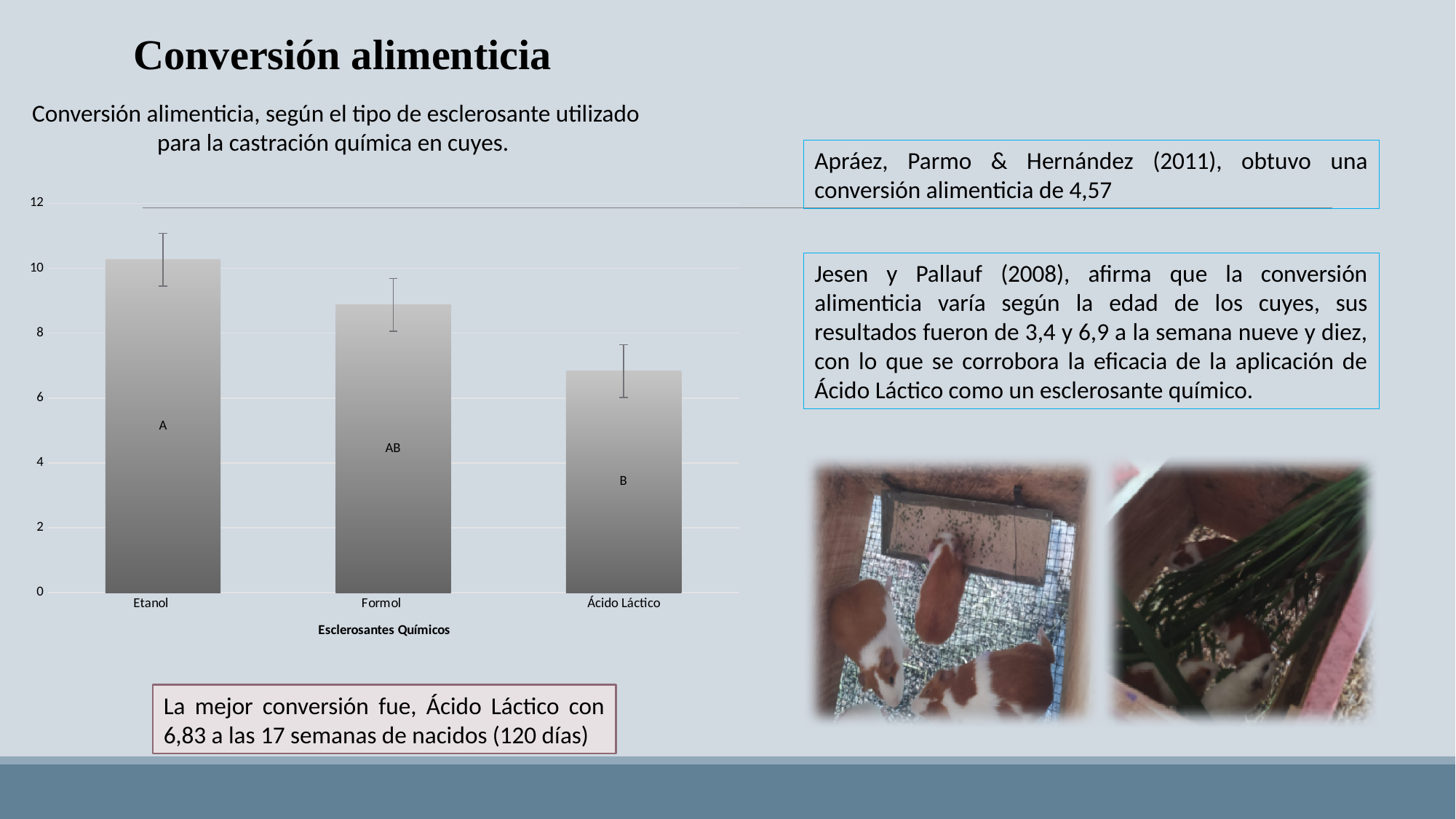
Which has a larger value in the chart, Etanol or Formol? Etanol Do the bar values rise or fall from Etanol to Ácido Láctico along the x axis? fall Which esclerosante has the lowest conversión alimenticia in the chart? Ácido Láctico Is the value for Formol greater or less than 10? less What is the title of the x axis of the chart? Esclerosantes Químicos What kind of chart is shown on the slide? bar chart Is the value for Ácido Láctico greater or less than 8? less Is the value for Formol greater or less than 8? greater Which esclerosante has the highest conversión alimenticia in the chart? Etanol What letter label is printed on the Formol bar? AB How many categories (esclerosantes) are plotted in the chart? 3